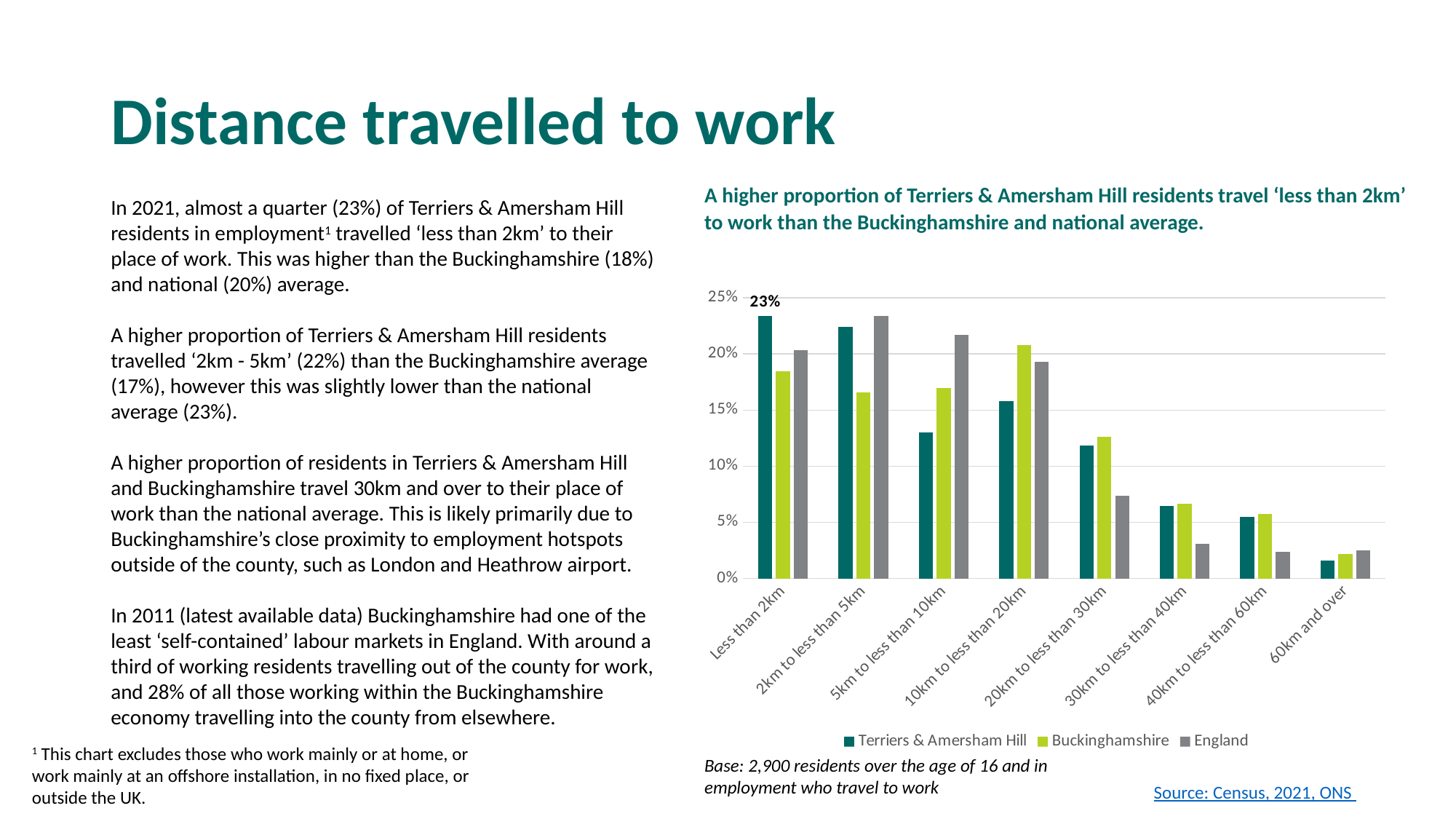
Is the value for England in the '30km to less than 40km' category greater or less than 5%? less In the '10km to less than 20km' category, which is larger: Terriers & Amersham Hill or Buckinghamshire? Buckinghamshire Which distance category has the highest value for Buckinghamshire? 10km to less than 20km Which distance category has the lowest value for Terriers & Amersham Hill? 60km and over What is the value for Terriers & Amersham Hill in the 'Less than 2km' category? 23% How many series does the legend list? 3 What kind of chart is shown on the slide? Bar chart Do the values for Terriers & Amersham Hill generally rise or fall as distance increases along the x axis? Fall How many distance categories are shown on the x axis? 8 Is the value for Terriers & Amersham Hill in the '20km to less than 30km' category greater or less than 10%? greater Which distance category has the highest value for England? 2km to less than 5km In the 'Less than 2km' category, which is larger: Terriers & Amersham Hill or Buckinghamshire? Terriers & Amersham Hill